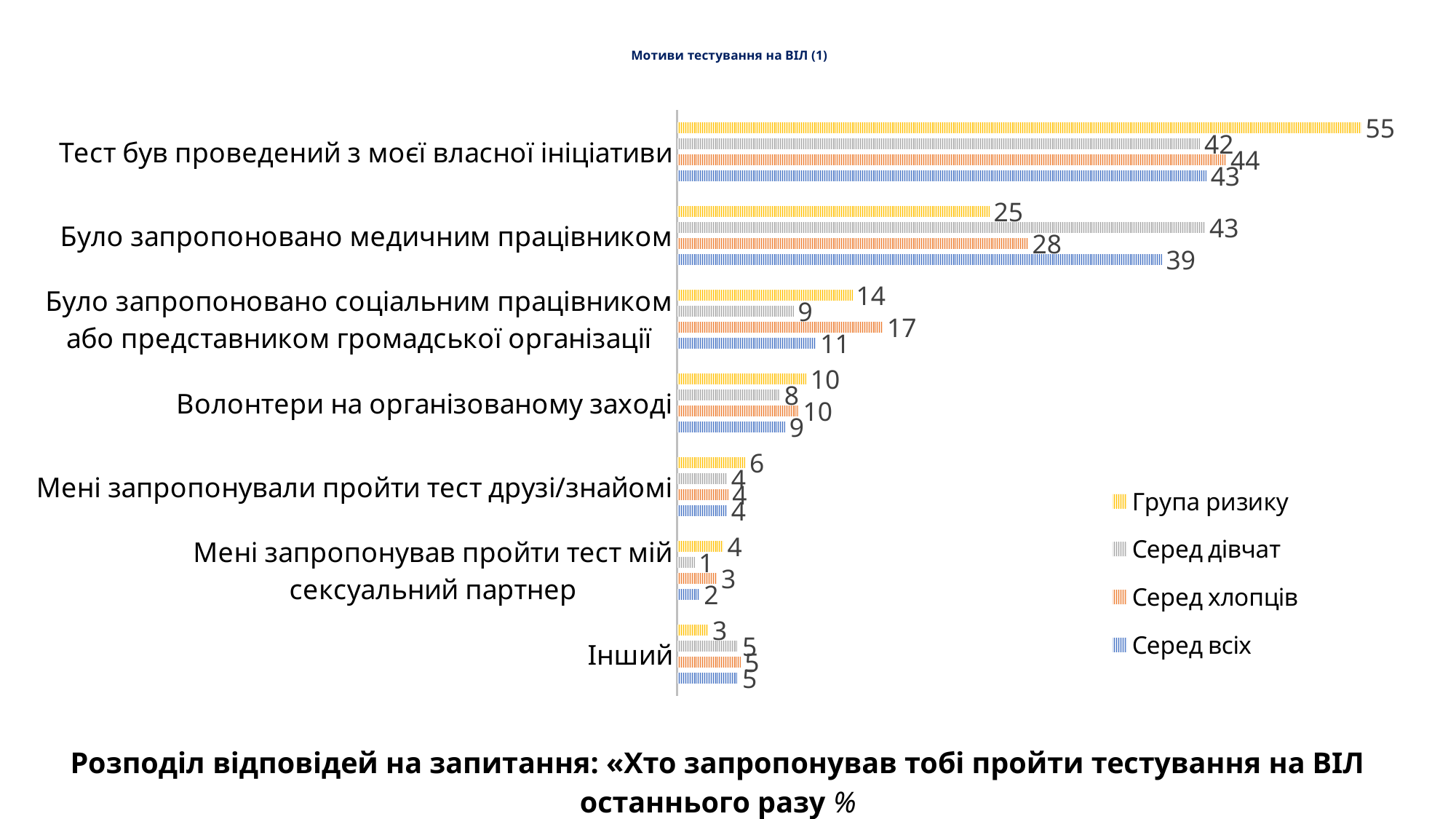
What is the value for "Серед всіх" in the category "Волонтери на організованому заході"? 9 Which series is shown in blue according to the legend? Серед всіх Which category has the highest value for the "Серед всіх" series? Тест був проведений з моєї власної ініціативи What is the value for "Серед хлопців" in the category "Було запропоновано соціальним працівником або представником громадської організації"? 17 Which category has the lowest value for the "Серед дівчат" series? Мені запропонував пройти тест мій сексуальний партнер What is the value for "Група ризику" in the category "Тест був проведений з моєї власної ініціативи"? 55 What kind of chart is shown on the slide? Bar chart What is the value for "Серед дівчат" in the category "Було запропоновано медичним працівником"? 43 In the category "Тест був проведений з моєї власної ініціативи", which is larger: the value for "Серед хлопців" or for "Серед дівчат"? Серед хлопців How many categories are shown on the chart? 7 What is the difference between the "Група ризику" and "Серед дівчат" values in the category "Було запропоновано медичним працівником"? 18 How many series does the legend list? 4